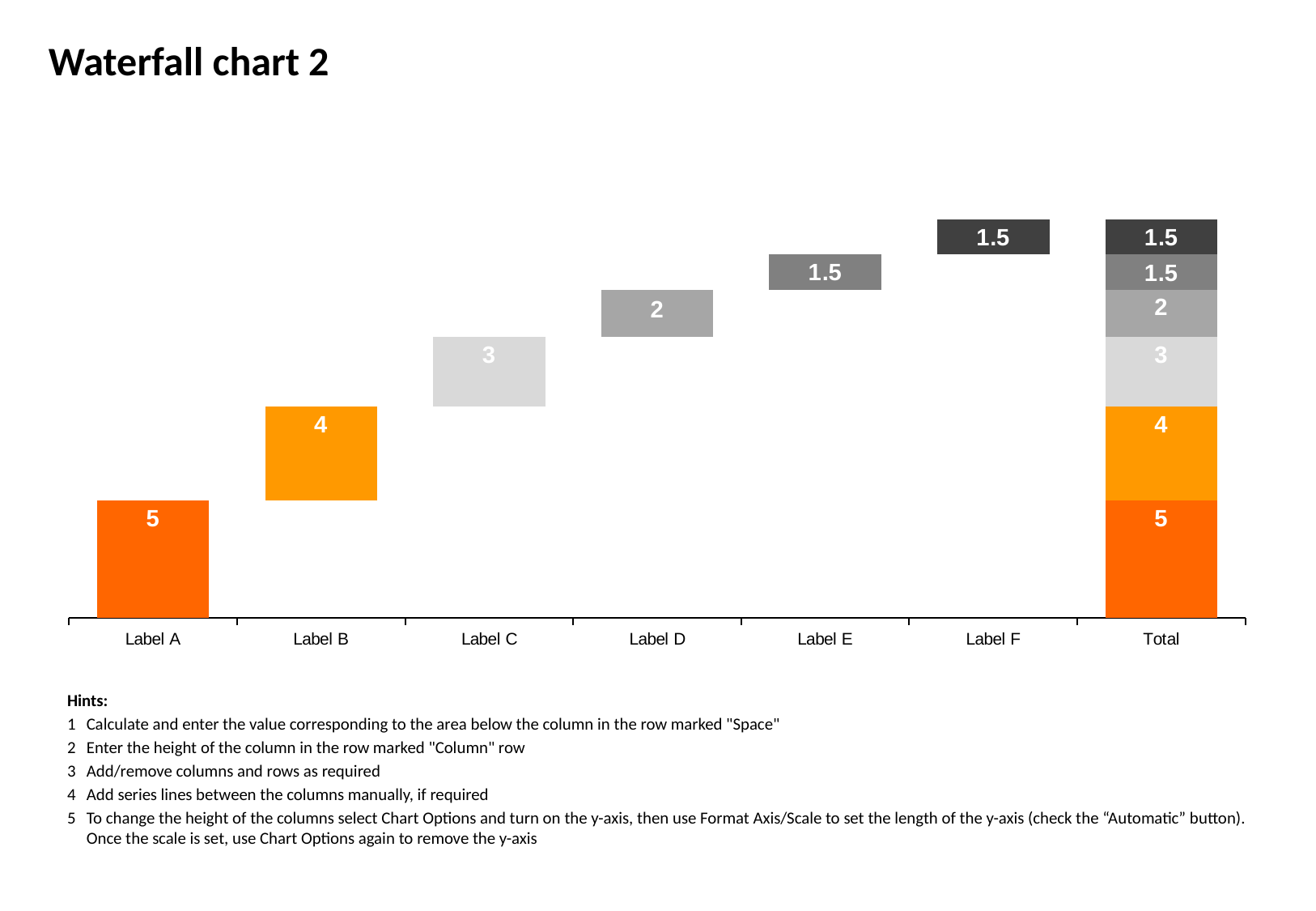
What is the value for Label A? 5 How many categories are shown on the x axis? 7 What is the value for Label D? 2 What is the difference between the values for Label A and Label B? 1 What is the value for Label E? 1.5 Which is larger, the value for Label B or the value for Label D? Label B What is the title of the slide? Waterfall chart 2 What is the value for Label C? 3 What is the total of the stacked Total bar? 17 What is the difference between the values for Label C and Label E? 1.5 Do the values rise or fall from Label A to Label F? fall